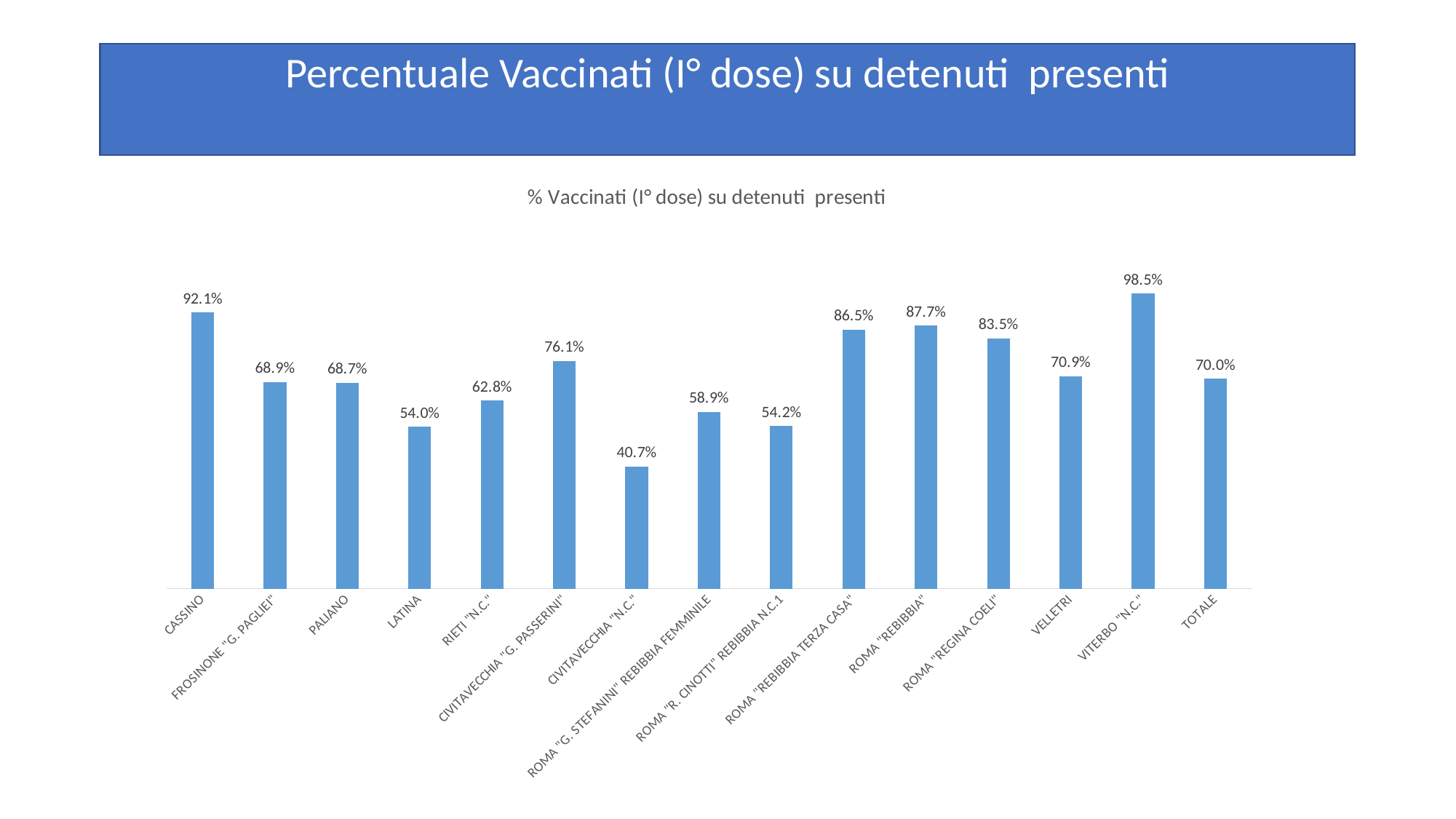
How many categories are shown on the x axis? 15 What kind of chart is shown on the slide? Bar chart What is the value for TOTALE? 70.0% What is the value for ROMA "REGINA COELI"? 83.5% What is the difference between the values for VITERBO "N.C." and CIVITAVECCHIA "N.C."? 57.8% What is the title of the chart? % Vaccinati (I° dose) su detenuti presenti What is the difference between the values for ROMA "REBIBBIA" and ROMA "REBIBBIA TERZA CASA"? 1.2% Which category has the highest value? VITERBO "N.C." What is the value for VITERBO "N.C."? 98.5% What is the value for CASSINO? 92.1% Which is larger, the value for LATINA or the value for RIETI "N.C."? RIETI "N.C." Which category has the lowest value? CIVITAVECCHIA "N.C."